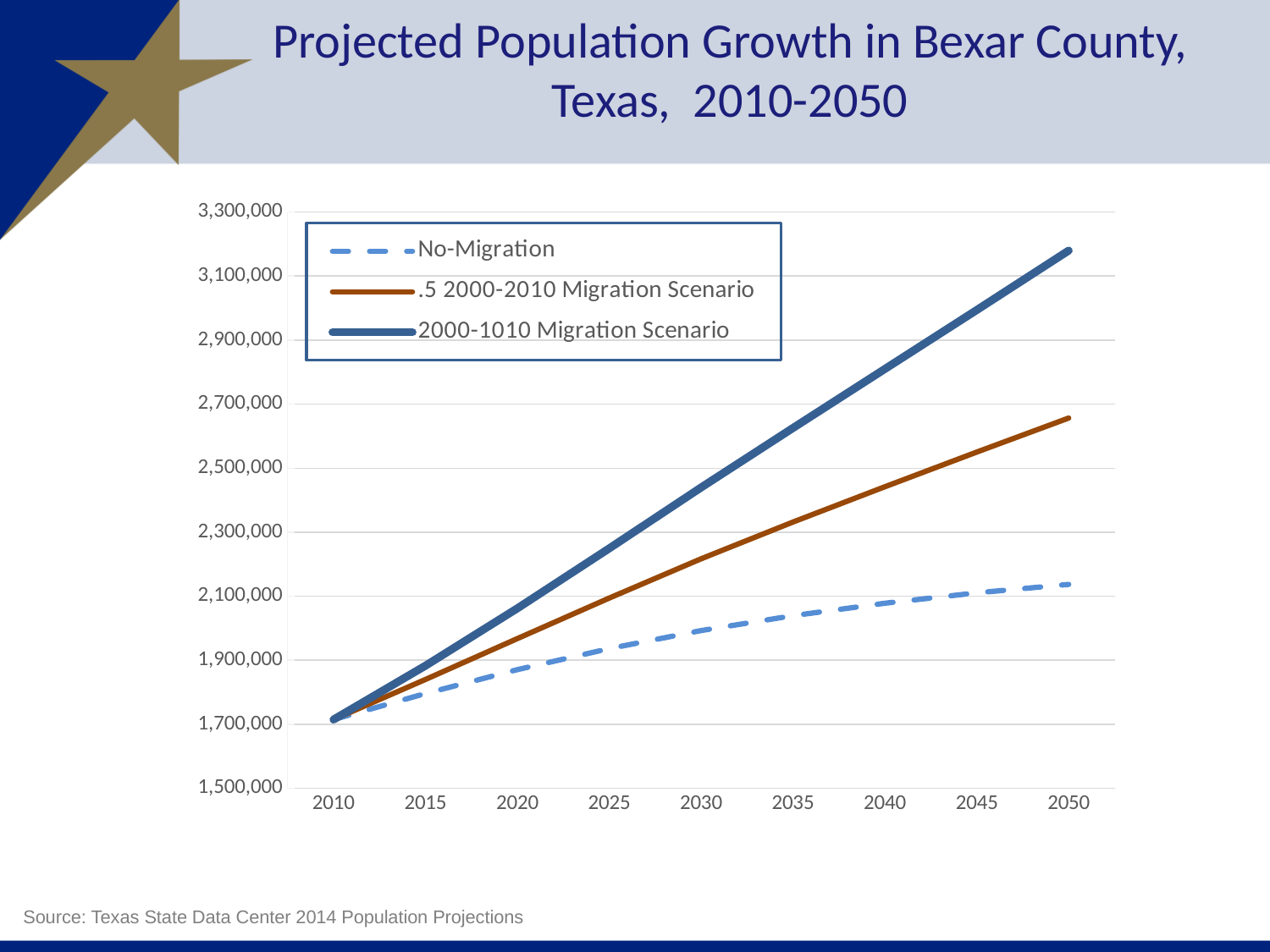
What is the title of the chart? Projected Population Growth in Bexar County, Texas, 2010-2050 Is the value for the 2000-1010 Migration Scenario in 2050 greater or less than 3,100,000? greater What kind of chart is shown on the slide? line chart Which series has the highest value in 2050? 2000-1010 Migration Scenario How many series does the legend list? 3 In 2040, which is larger: the .5 2000-2010 Migration Scenario or the No-Migration series? .5 2000-2010 Migration Scenario Which series is drawn with a dashed line? No-Migration Do the values for the No-Migration series rise or fall from 2010 to 2050? rise Which series has the lowest value in 2050? No-Migration Is the value for the No-Migration series in 2030 greater or less than 2,100,000? less Is the value for the .5 2000-2010 Migration Scenario in 2050 greater or less than 2,700,000? less How many year labels are shown along the x axis? 9